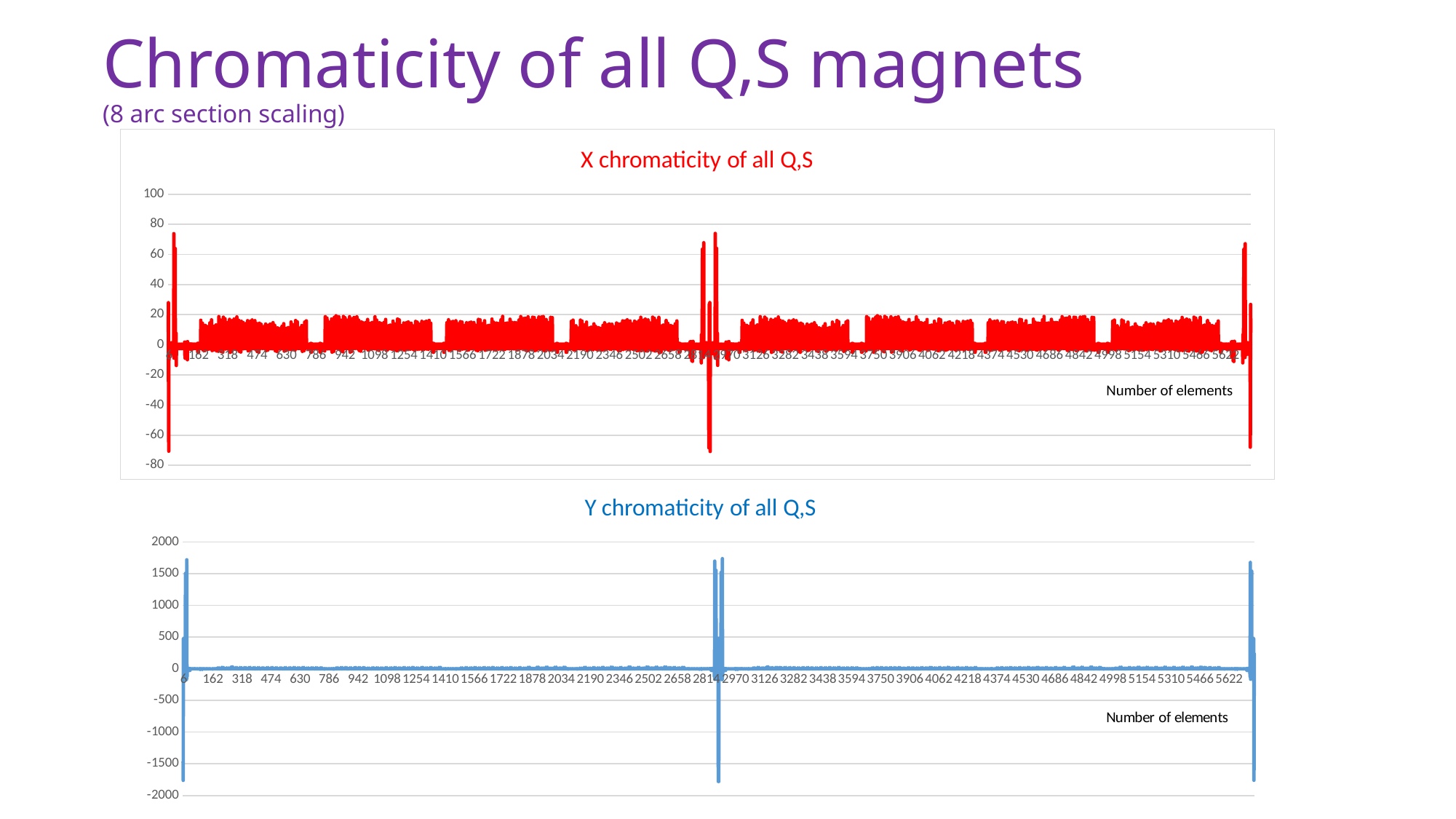
What kind of chart is the 'Y chromaticity of all Q,S' chart? line chart In the 'X chromaticity of all Q,S' chart, is the lowest spike greater or less than -60? less In the 'Y chromaticity of all Q,S' chart, is the lowest spike greater or less than -1500? less In the 'X chromaticity of all Q,S' chart, is the highest spike greater or less than 60? greater What is the x-axis label shown on the bottom chart? Number of elements What is the title of the top chart on the slide? X chromaticity of all Q,S What kind of chart is the 'X chromaticity of all Q,S' chart? line chart What is the minimum value shown on the y-axis of the 'X chromaticity of all Q,S' chart? -80 How many charts are shown on the slide? 2